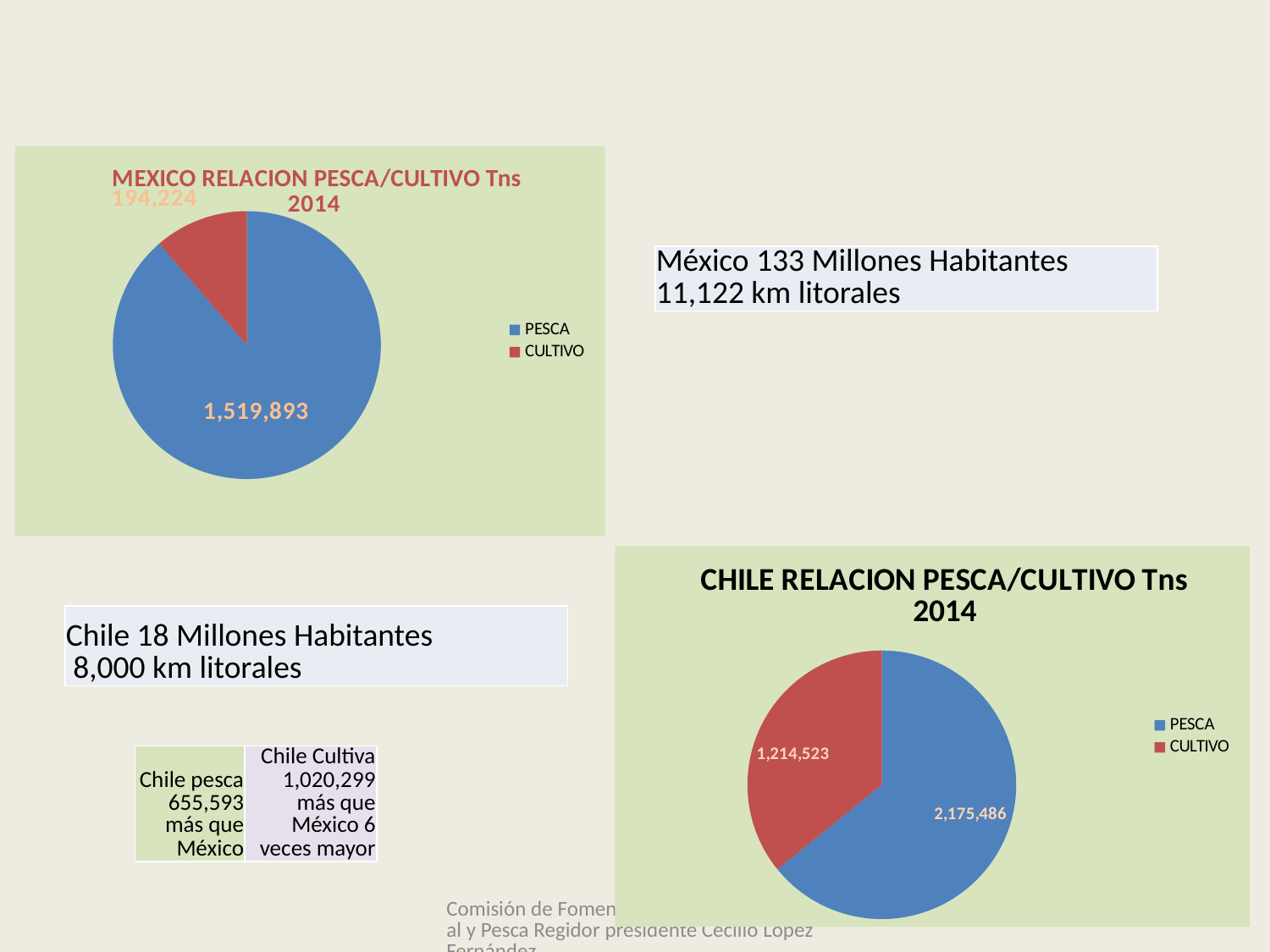
In the MEXICO RELACION PESCA/CULTIVO Tns 2014 chart, what is the difference between PESCA and CULTIVO? 1,325,669 In the CHILE RELACION PESCA/CULTIVO Tns 2014 chart, what colour is the CULTIVO slice? Red In the CHILE RELACION PESCA/CULTIVO Tns 2014 chart, what is the value for PESCA? 2,175,486 In the CHILE RELACION PESCA/CULTIVO Tns 2014 chart, what is the difference between PESCA and CULTIVO? 960,963 In the MEXICO RELACION PESCA/CULTIVO Tns 2014 chart, what is the value for CULTIVO? 194,224 What type of chart is the CHILE RELACION PESCA/CULTIVO Tns 2014 chart? Pie chart In the CHILE RELACION PESCA/CULTIVO Tns 2014 chart, what is the value for CULTIVO? 1,214,523 In the CHILE RELACION PESCA/CULTIVO Tns 2014 chart, which category has the smallest slice? CULTIVO In the MEXICO RELACION PESCA/CULTIVO Tns 2014 chart, which category has the largest slice? PESCA In the MEXICO RELACION PESCA/CULTIVO Tns 2014 chart, what is the value for PESCA? 1,519,893 How many series does the legend of the MEXICO RELACION PESCA/CULTIVO Tns 2014 chart list? 2 Which is larger: the CULTIVO value in the Chile chart or the CULTIVO value in the Mexico chart? Chile